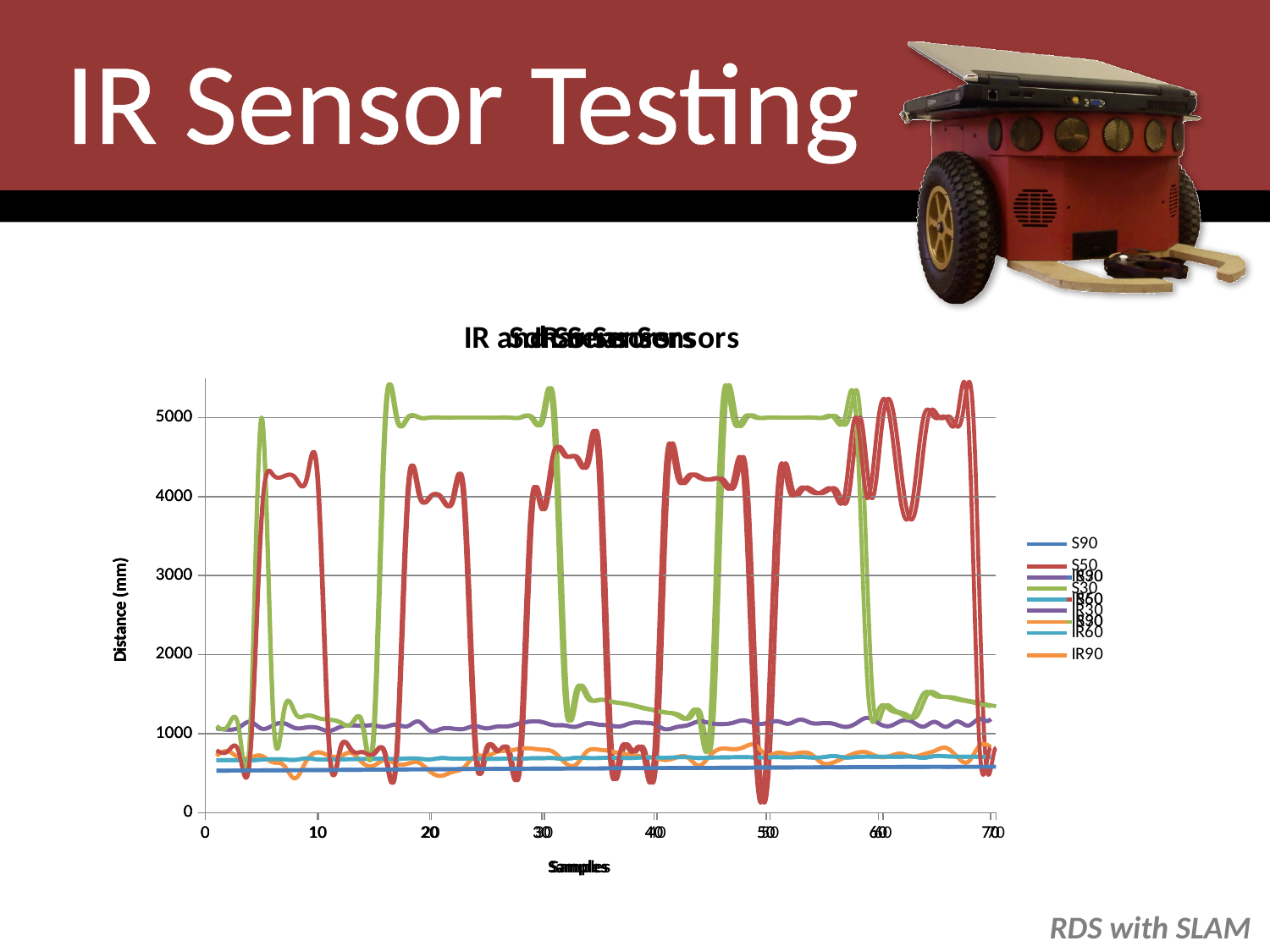
Is the value of the purple line at sample 30 greater or less than 1000? greater What is the label of the x axis of the chart? Samples Is the value of the purple line at sample 30 greater or less than 2000? less Is the value of the green line at sample 20 greater or less than 4000? greater At sample 20, which line is higher: the green line or the red S50 line? the green line At sample 30, which line is higher: the purple line or the blue S90 line? the purple line What kind of chart is shown on the slide? line chart What is the label of the y axis of the chart? Distance (mm)